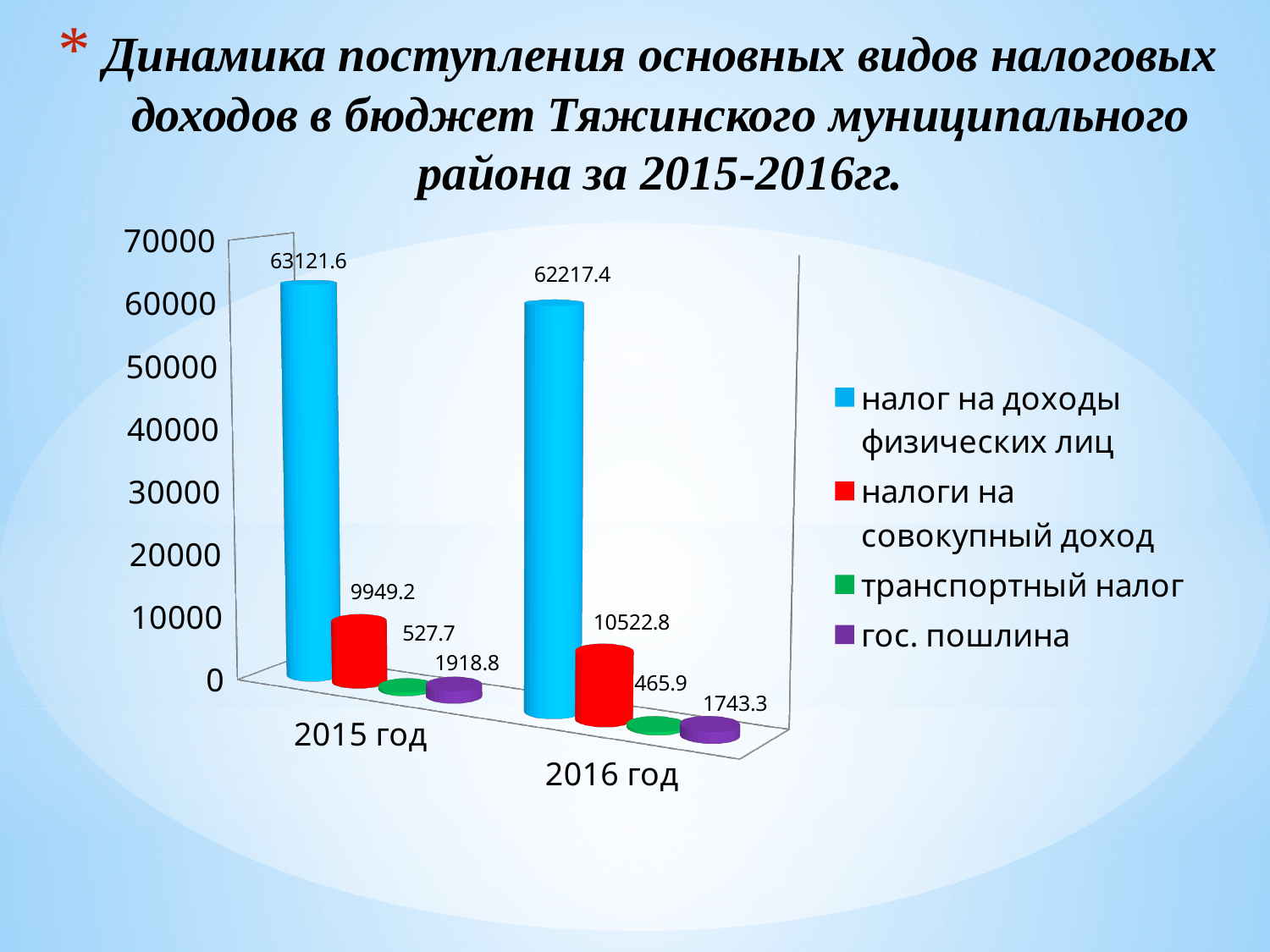
What kind of chart is shown on the slide? bar chart Does the value for гос. пошлина rise or fall from 2015 год to 2016 год? fall What is the value for налоги на совокупный доход in 2016 год? 10522.8 How many categories are shown on the x axis? 2 What is the value for транспортный налог in 2015 год? 527.7 What is the value for налог на доходы физических лиц in 2015 год? 63121.6 What is the value for гос. пошлина in 2016 год? 1743.3 Which is larger: налоги на совокупный доход in 2015 год or in 2016 год? 2016 год How many series does the legend list? 4 Which series has the lowest value in 2015 год? транспортный налог Which series has the highest value in 2016 год? налог на доходы физических лиц What is the difference between the налог на доходы физических лиц values for 2015 год and 2016 год? 904.2